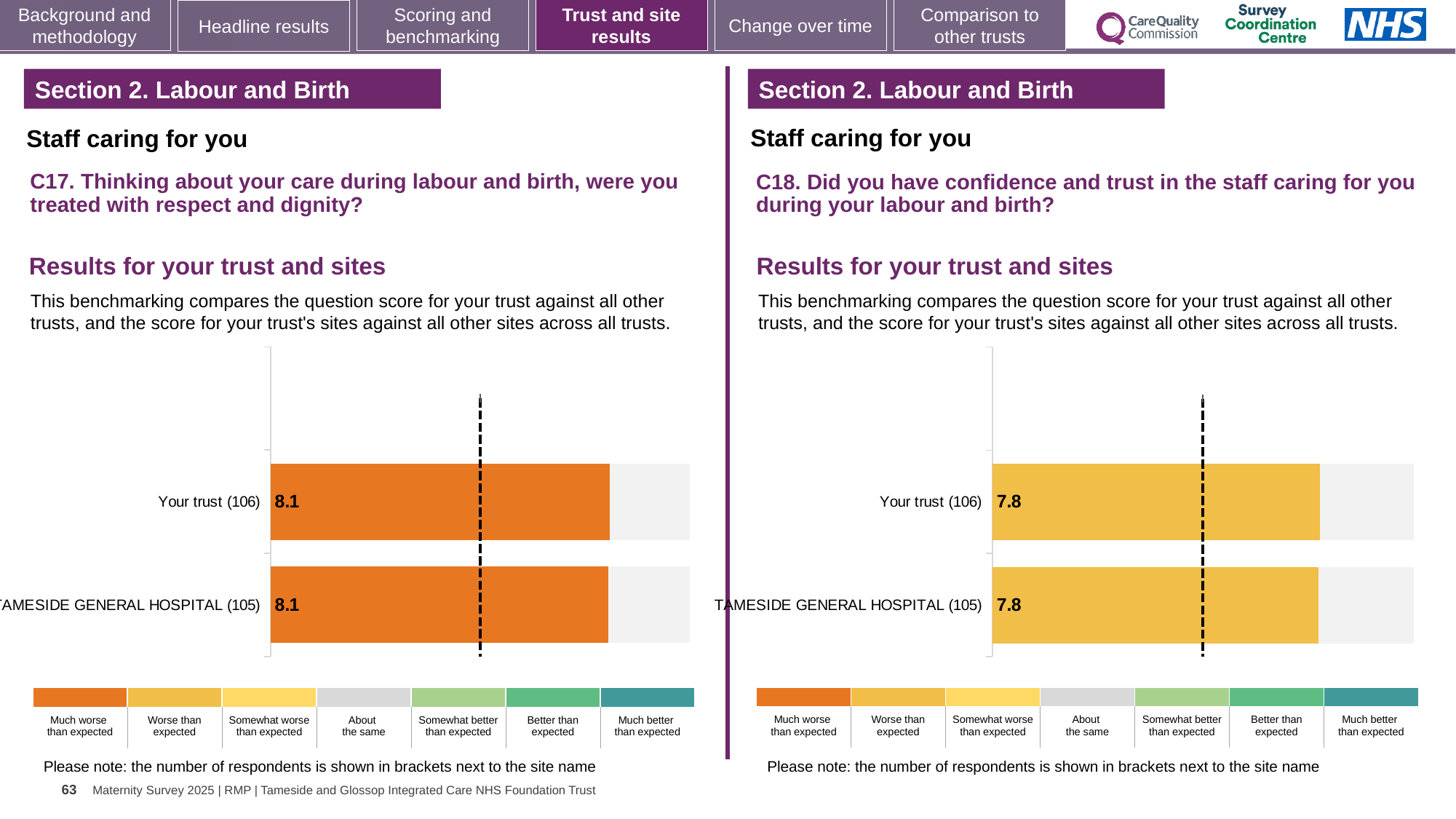
In the C17 chart on the left, what is the score for Your trust (106)? 8.1 What kind of chart is used for the C17 results on the left? Bar chart In the C18 chart on the right, what is the score for Your trust (106)? 7.8 In the C18 chart on the right, what is the score for TAMESIDE GENERAL HOSPITAL (105)? 7.8 In the C18 chart on the right, what is the difference between the score for Your trust (106) and the score for TAMESIDE GENERAL HOSPITAL (105)? 0.0 According to the legend, which benchmarking category does the colour of the bars in the C18 chart on the right represent? Worse than expected How many bars are plotted in the C17 chart on the left? 2 How many bars are plotted in the C18 chart on the right? 2 According to the legend, which benchmarking category does the orange colour of the bars in the C17 chart on the left represent? Much worse than expected In the C17 chart on the left, what is the difference between the score for Your trust (106) and the score for TAMESIDE GENERAL HOSPITAL (105)? 0.0 In the C17 chart on the left, what is the score for TAMESIDE GENERAL HOSPITAL (105)? 8.1 How many respondents are shown in brackets for TAMESIDE GENERAL HOSPITAL in the C18 chart on the right? 105